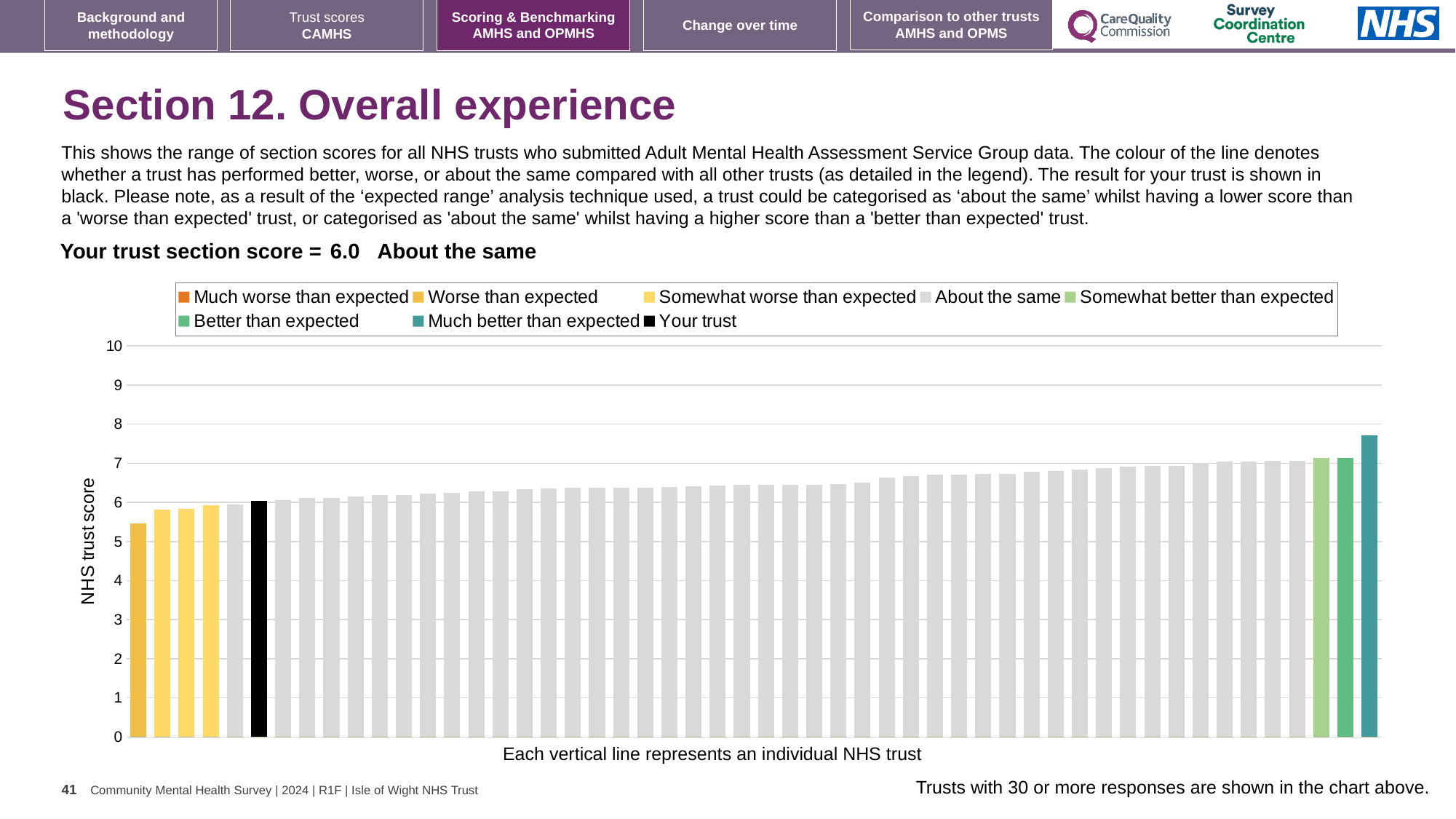
What is the section score for your trust, as stated on the slide? 6.0 Is the value of the tallest bar greater or less than 7? greater Do the bar values rise or fall from left to right along the x axis? rise Which legend category does the tallest bar belong to? Much better than expected Which category is your trust placed in, according to the text above the chart? About the same How many entries does the chart legend list? 8 What kind of chart is shown on the slide? bar chart How many bars are coloured as 'Somewhat worse than expected'? 3 Is the value of the tallest bar greater or less than 8? less Is the value of the leftmost (lowest) bar greater or less than 6? less What is the label on the vertical axis of the chart? NHS trust score Which is larger, the leftmost bar or the black bar for your trust? your trust